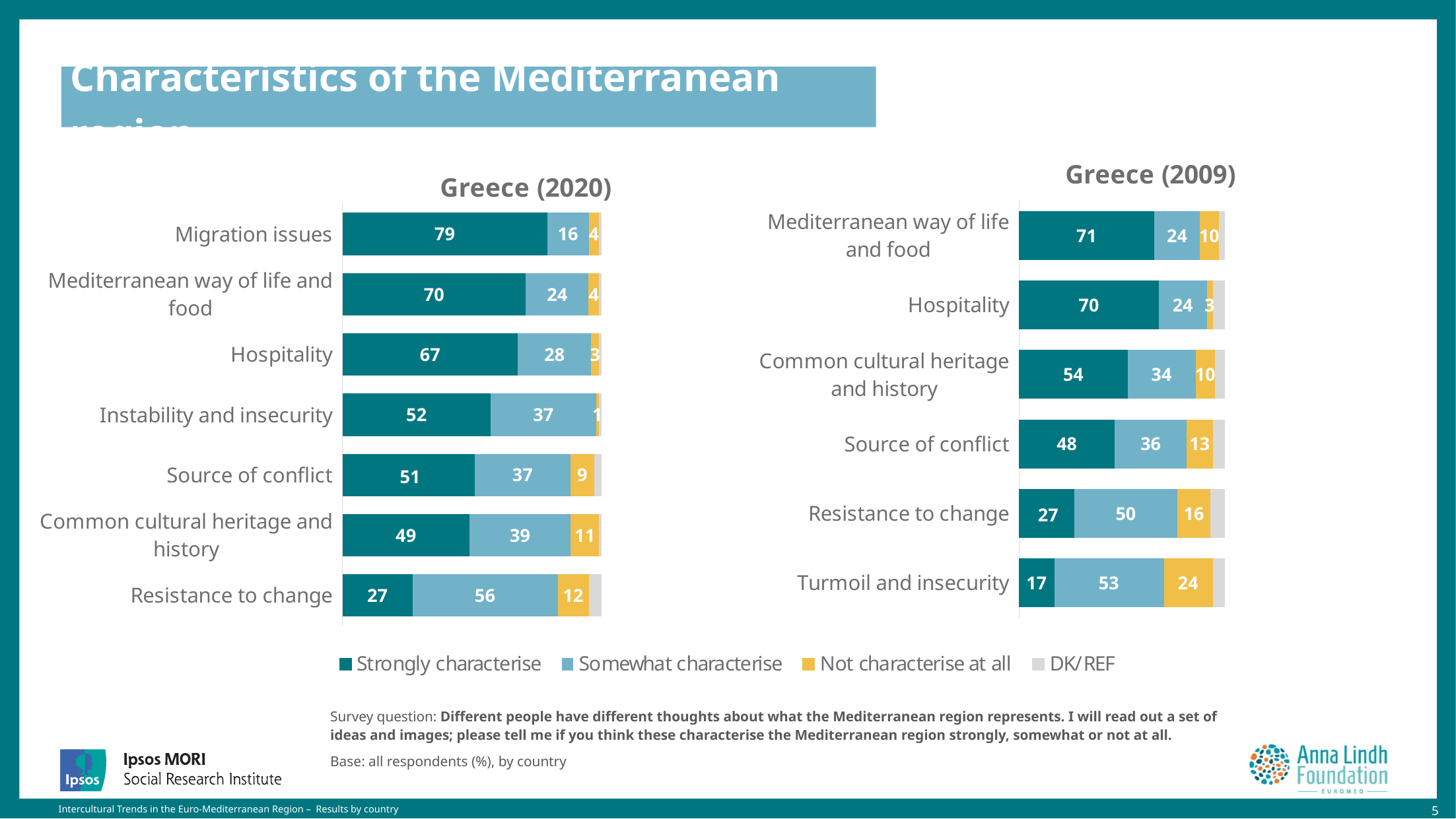
In the Greece (2009) chart, what is the 'Strongly characterise' value for Common cultural heritage and history? 54 How many categories are shown in the Greece (2020) chart? 7 In the Greece (2020) chart, what is the difference between the 'Strongly characterise' values for Migration issues and Hospitality? 12 In the Greece (2009) chart, what is the difference between the 'Strongly characterise' values for Hospitality and Resistance to change? 43 In the Greece (2020) chart, what is the 'Somewhat characterise' value for Resistance to change? 56 In the Greece (2009) chart, which is larger: the 'Somewhat characterise' value for Resistance to change or for Source of conflict? Resistance to change In the Greece (2020) chart, which category has the highest 'Strongly characterise' value? Migration issues In the Greece (2020) chart, what percentage say migration issues strongly characterise the Mediterranean region? 79 What type of chart is used for Greece (2009)? Stacked bar chart How many series does the legend list? 4 In the Greece (2009) chart, what is the 'Not characterise at all' value for Turmoil and insecurity? 24 In the Greece (2009) chart, which category has the lowest 'Strongly characterise' value? Turmoil and insecurity